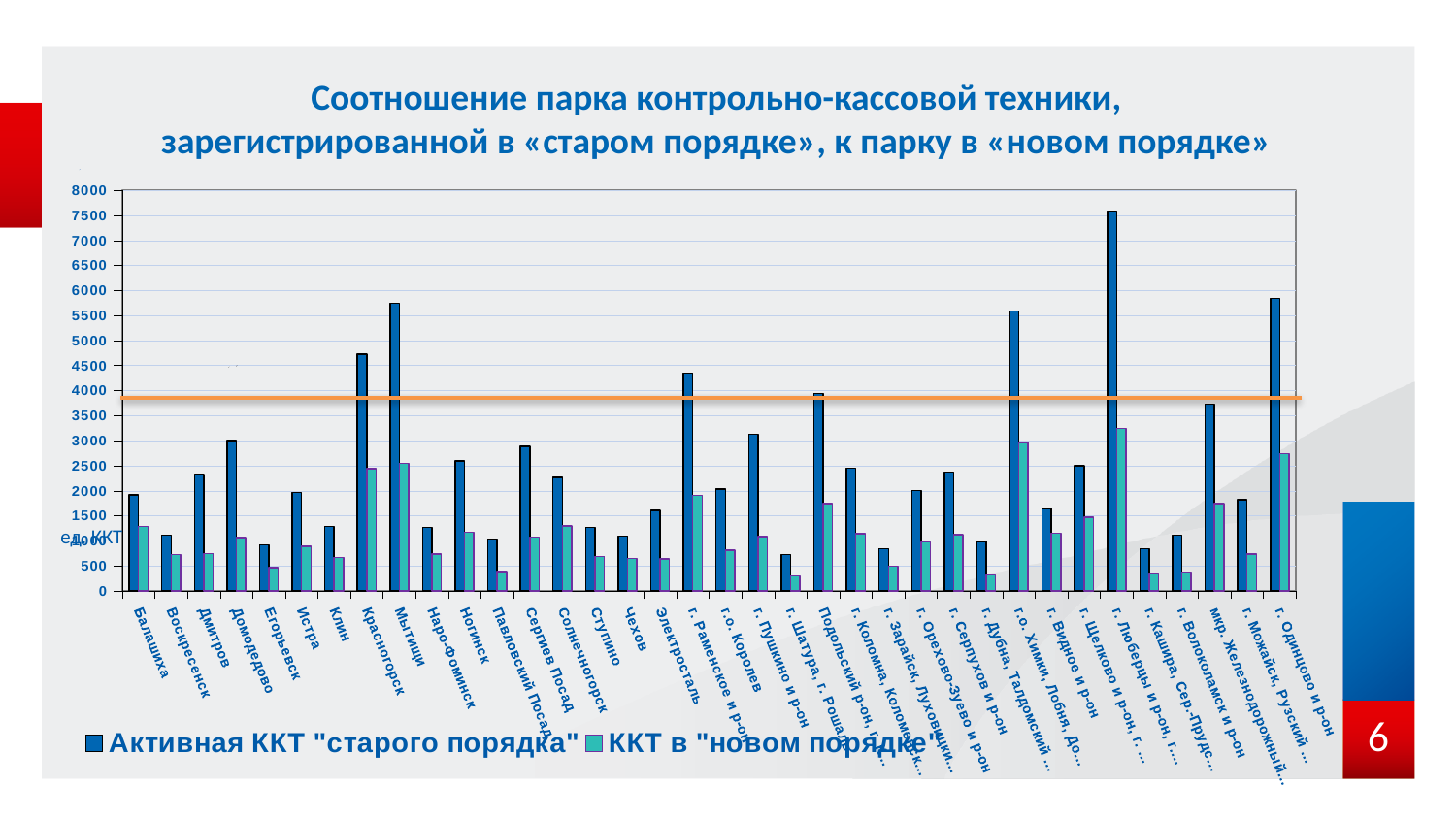
What kind of chart is shown on the slide? bar chart How many series does the legend list? 2 Which is larger for Активная ККТ "старого порядка": Мытищи or Красногорск? Мытищи Is the value for г. Люберцы и р-он in the series Активная ККТ "старого порядка" greater or less than 7000? greater How many categories are shown on the x axis? 36 Is the value for г. Раменское и р-он in the series Активная ККТ "старого порядка" greater or less than 4000? greater Is the value for Мытищи in the series Активная ККТ "старого порядка" greater or less than 5500? greater Which is larger for Активная ККТ "старого порядка": г. Люберцы и р-он or г. Одинцово и р-он? г. Люберцы и р-он Which category has the highest value for Активная ККТ "старого порядка"? г. Люберцы и р-он What is the name of the second series in the legend? ККТ в "новом порядке"